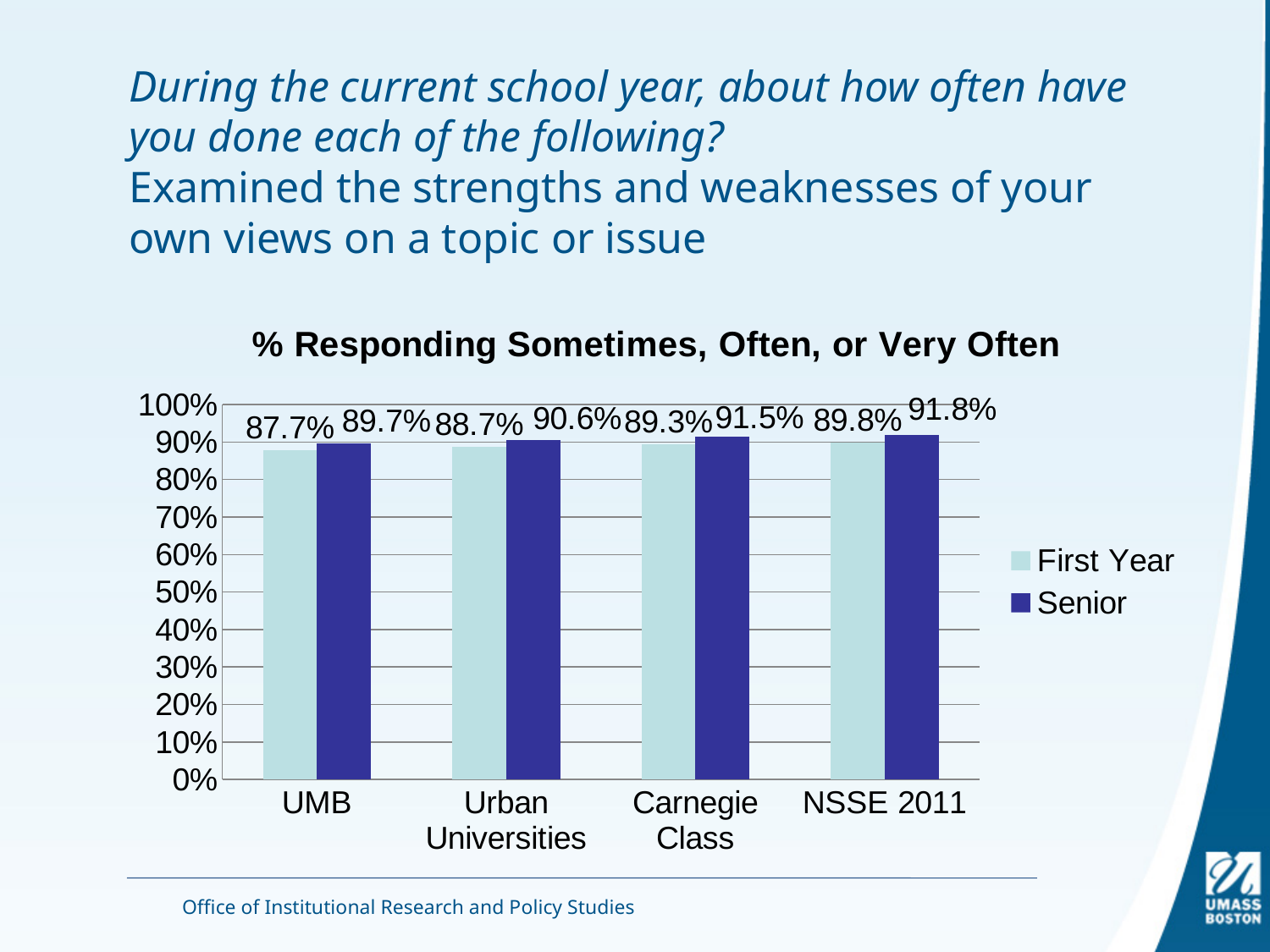
What is the difference between the Senior and First Year values for UMB? 2.0% How many categories are shown on the x axis? 4 What is the First Year value for UMB? 87.7% How many series does the legend list? 2 What kind of chart is shown on the slide? Bar chart Which category has the lowest First Year value? UMB What is the title of the chart? % Responding Sometimes, Often, or Very Often Which category has the highest Senior value? NSSE 2011 Which is larger for Carnegie Class, the First Year value or the Senior value? Senior What is the First Year value for Urban Universities? 88.7% What is the Senior value for Carnegie Class? 91.5% What is the Senior value for NSSE 2011? 91.8%